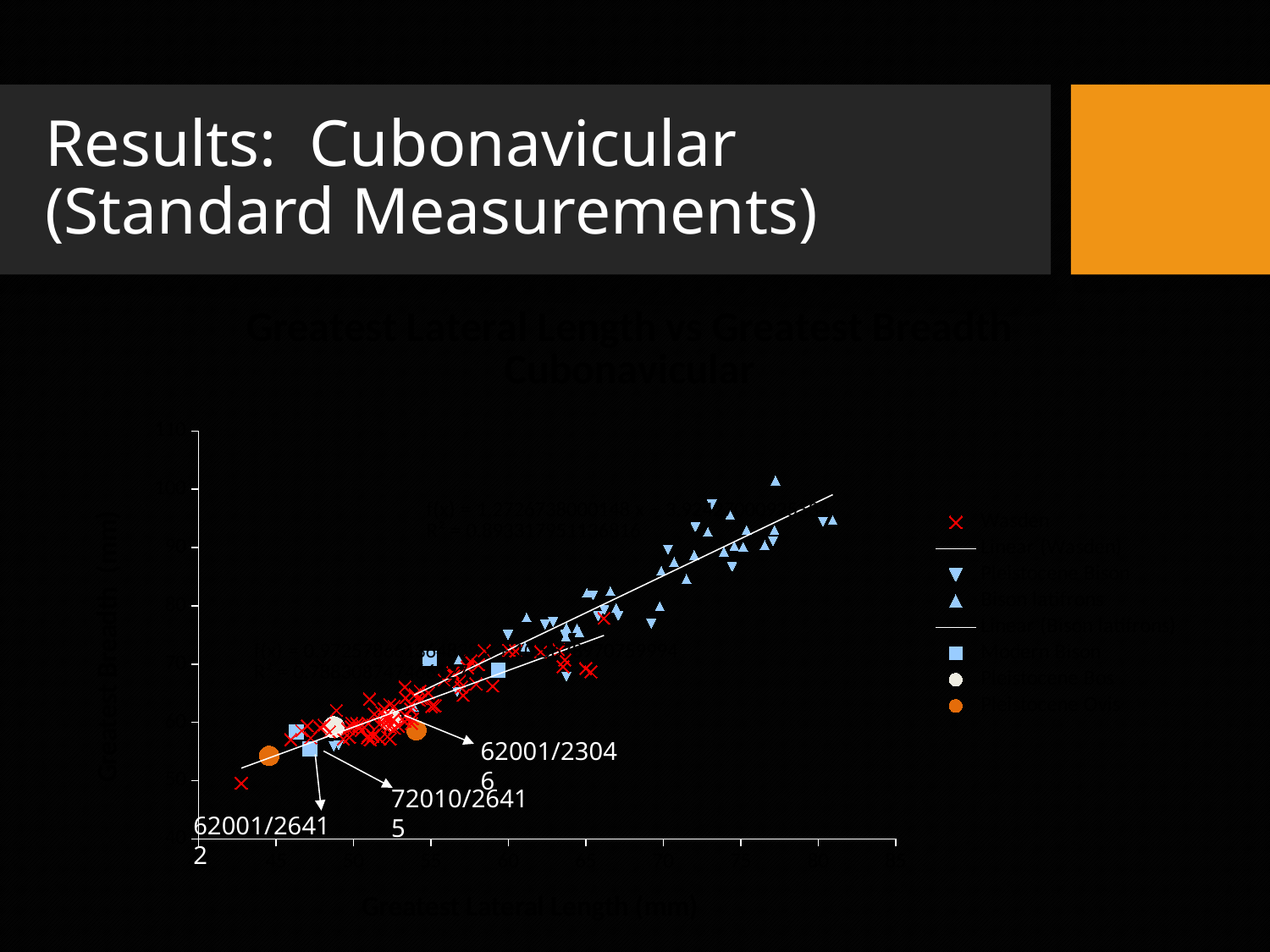
Do the plotted values generally rise or fall as Greatest Lateral Length increases along the x axis? rise How many straight trend lines are drawn through the data on the chart? 2 Which specimen ID label is attached by an arrow to the blue square marker at the lower left of the chart? 62001/2641 What kind of chart is shown on the slide? scatter chart Which specimen ID label is attached by an arrow to the orange circle marker near the middle of the chart? 62001/23046 How many data points on the chart are annotated with specimen ID labels? 3